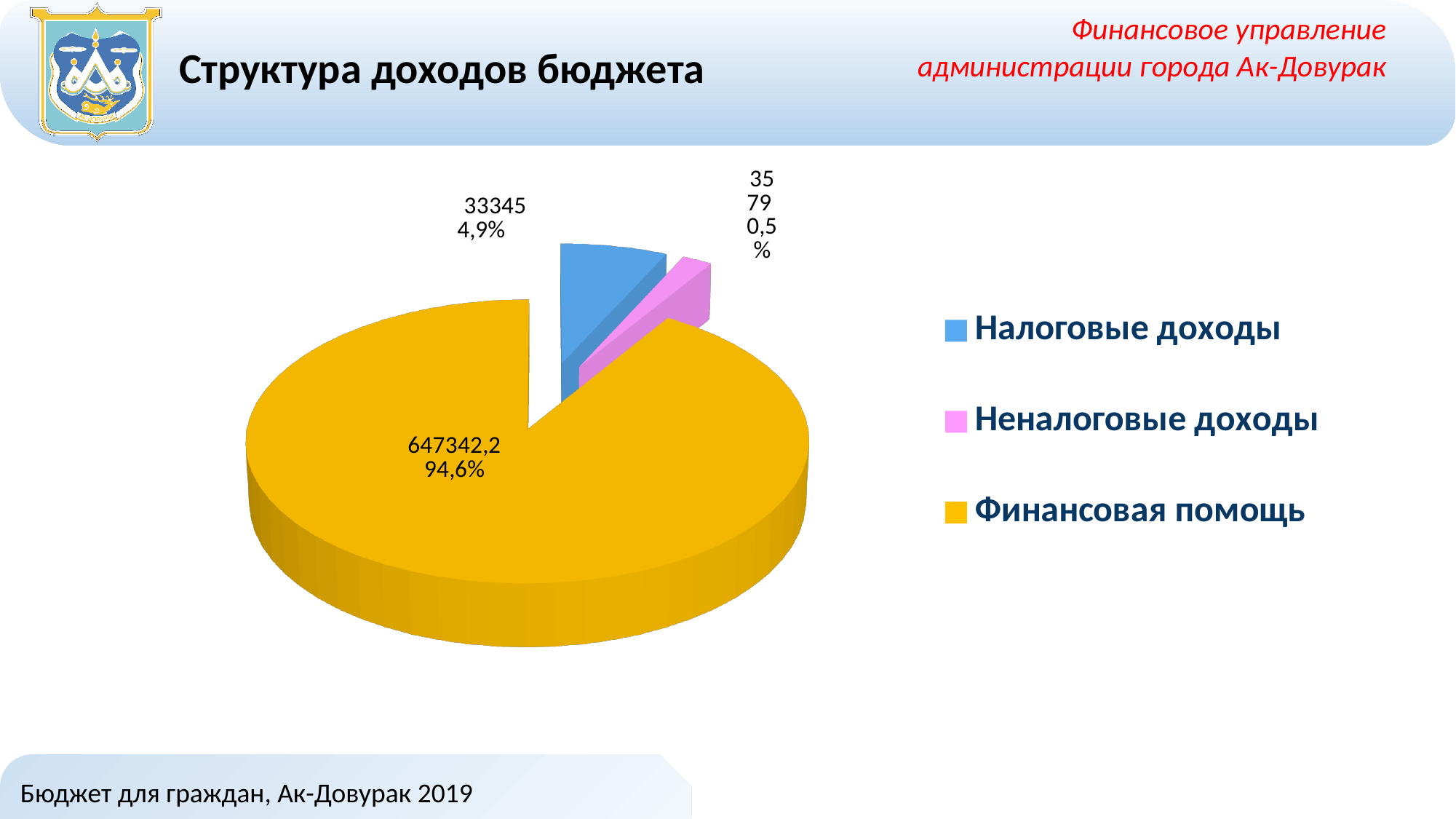
What share of the pie does Налоговые доходы take? 4,9% What is the value shown for Налоговые доходы? 33345 Which category has the smallest slice of the pie? Неналоговые доходы What colour is the slice for Финансовая помощь? yellow What share of the pie does Финансовая помощь take? 94,6% What share of the pie does Неналоговые доходы take? 0,5% Which category has the largest slice of the pie? Финансовая помощь What is the value shown for Финансовая помощь? 647342,2 What kind of chart is shown on the slide? pie chart How many slices does the pie chart have? 3 What is the title of the chart? Структура доходов бюджета Which is larger, Налоговые доходы or Неналоговые доходы? Налоговые доходы